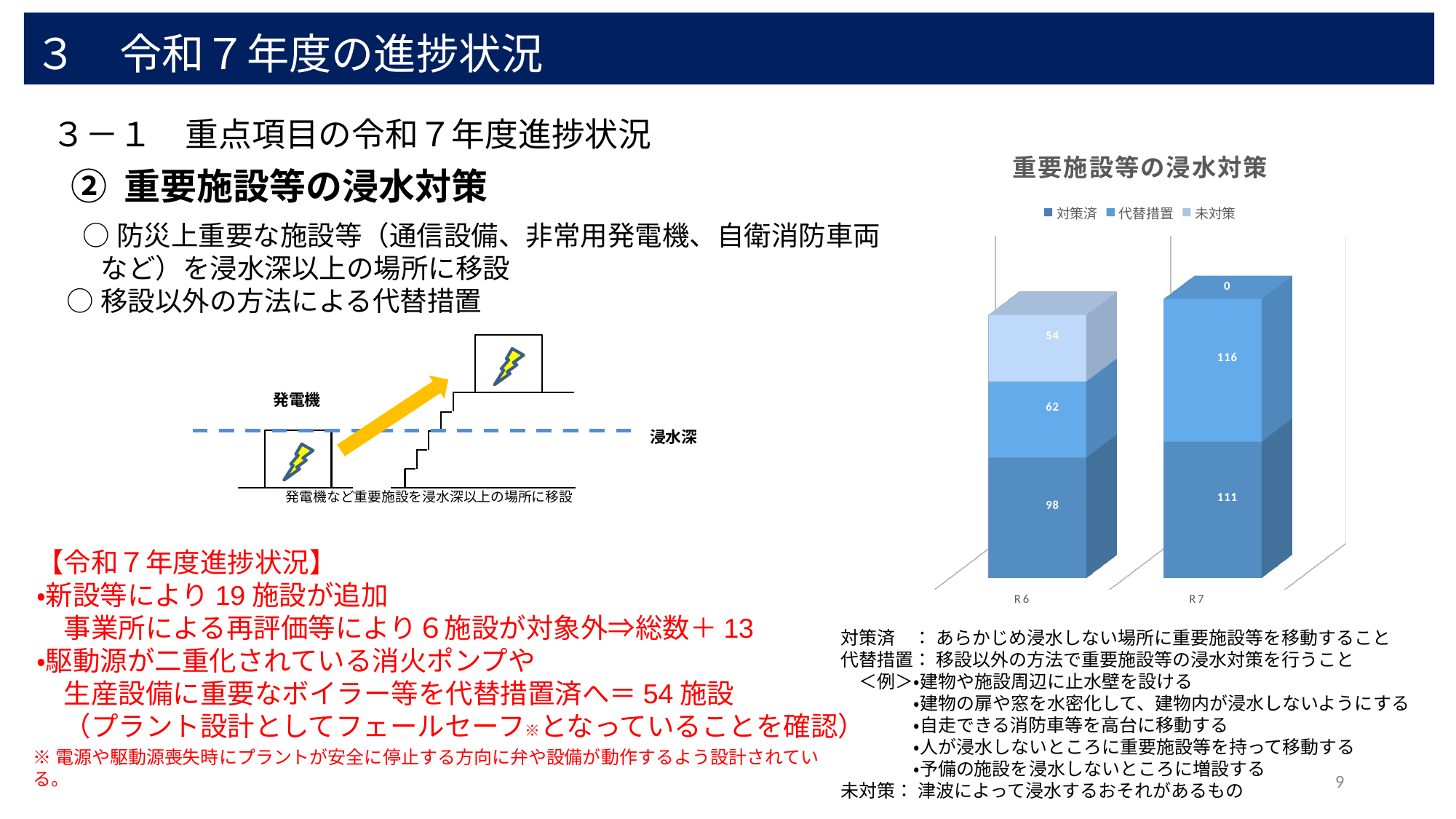
What is the value of 未対策 for R7? 0 What is the value of 代替措置 for R7? 116 What is the title of the chart on the slide? 重要施設等の浸水対策 How many series does the chart's legend list? 3 Which is larger, the 代替措置 value for R6 or for R7? R7 How many categories are shown on the x axis of the chart? 2 What kind of chart is shown on the slide? stacked bar chart What is the value of 対策済 for R6? 98 What is the total of the stacked bar for R6? 214 What is the value of 未対策 for R6? 54 What is the total of the stacked bar for R7? 227 What is the difference between the 対策済 values for R7 and R6? 13